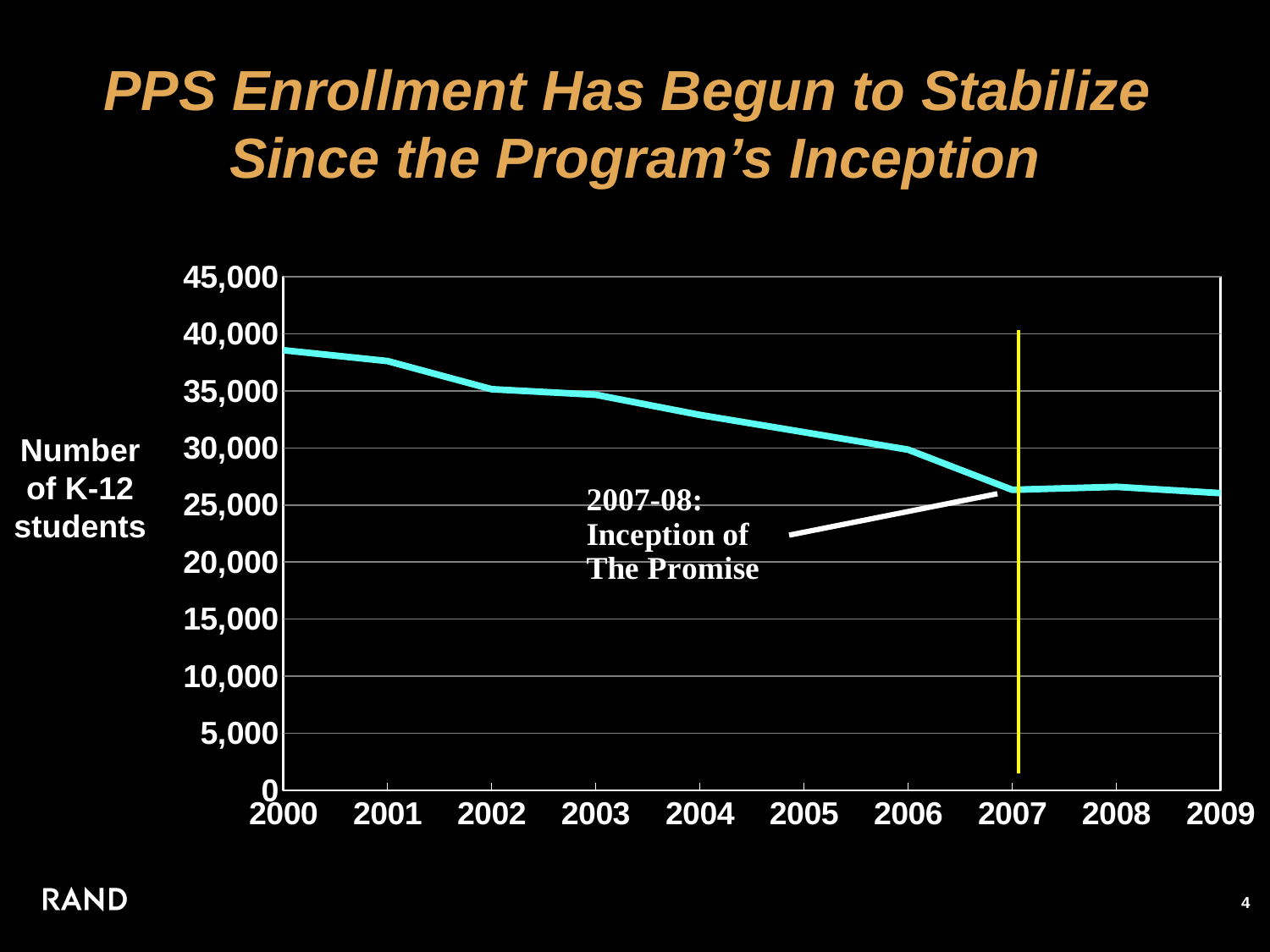
Which year has the larger number of K-12 students, 2000 or 2009? 2000 Which year has the highest number of K-12 students? 2000 What event does the annotation on the chart mark at 2007-08? Inception of The Promise Is the value for 2006 greater or less than 25,000? greater What is the label on the y axis of the chart? Number of K-12 students Is the value for 2007 greater or less than 30,000? less How many years are plotted along the x axis? 10 Does the number of K-12 students generally rise or fall from 2000 to 2009? fall Is the value for 2009 greater or less than 30,000? less What kind of chart is shown on the slide? line chart